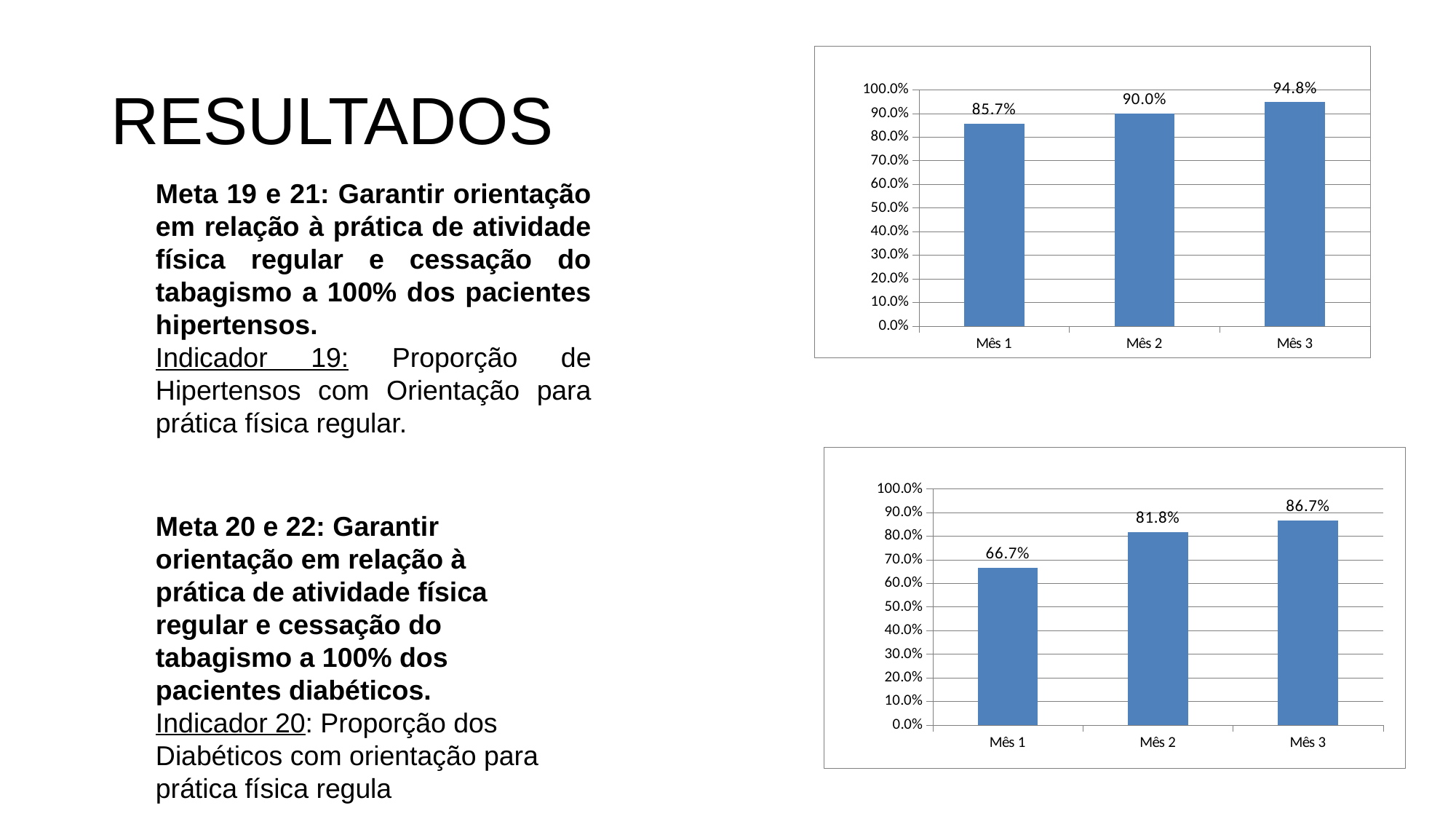
In the top chart, which month has the highest value? Mês 3 In the bottom chart, what is the value for Mês 2? 81.8% In the top chart, what is the value for Mês 1? 85.7% In the bottom chart, do the values rise or fall from Mês 1 to Mês 3? Rise In the bottom chart, what is the value for Mês 1? 66.7% In the top chart, what is the value for Mês 3? 94.8% In the bottom chart, how many months are shown on the x axis? 3 Which is larger: the value for Mês 2 in the top chart or the value for Mês 2 in the bottom chart? Mês 2 in the top chart In the bottom chart, what is the difference between the values for Mês 2 and Mês 1? 15.1% What kind of chart is the top chart? Bar chart In the bottom chart, which month has the lowest value? Mês 1 In the top chart, what is the difference between the values for Mês 3 and Mês 1? 9.1%